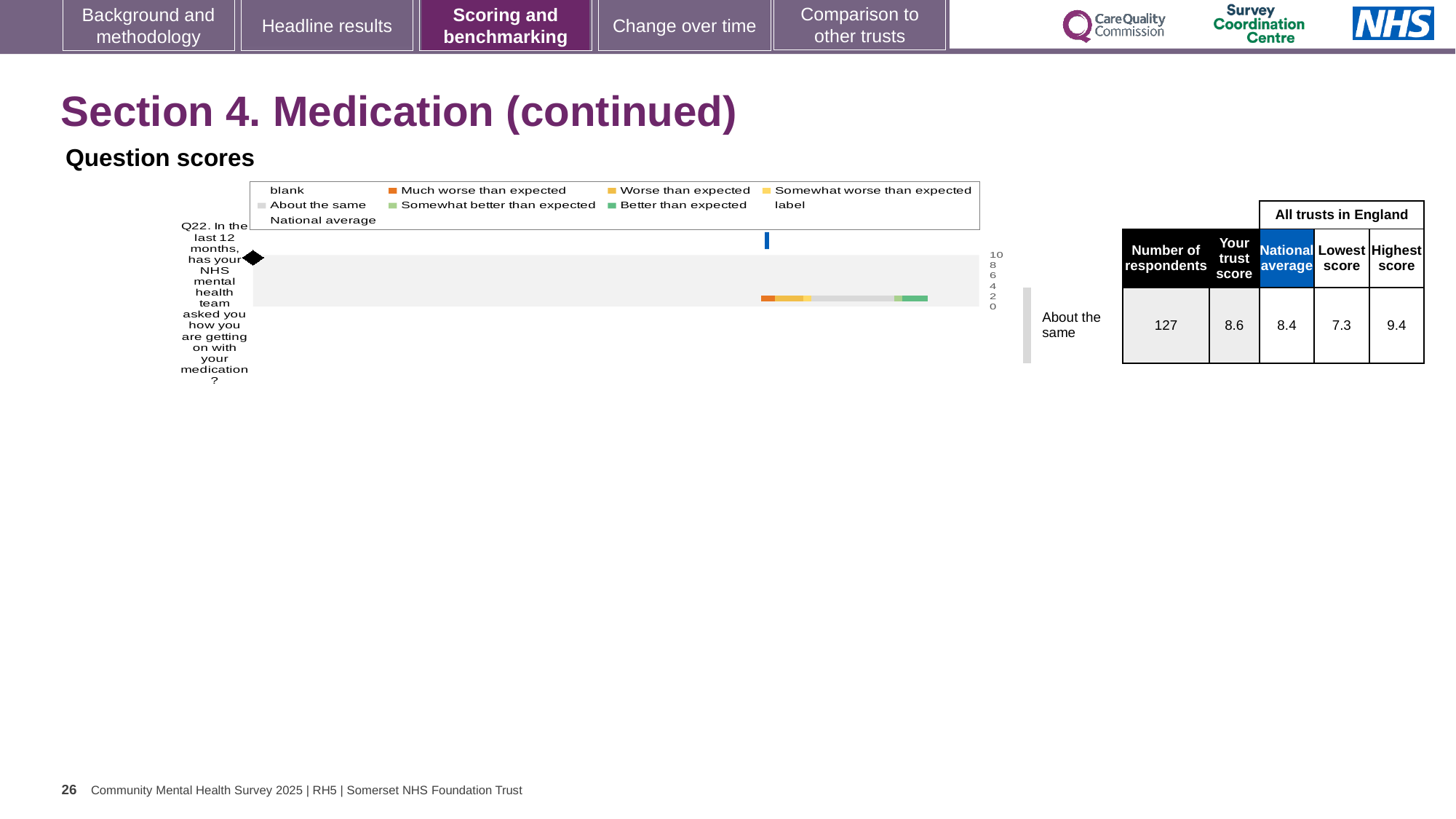
Which question is shown on the Question scores chart? Q22. In the last 12 months, has your NHS mental health team asked you how you are getting on with your medication? What is the national average score for Q22? 8.4 How many respondents answered Q22? 127 What kind of chart is the Question scores chart? bar chart What is the trust score for Q22 on the Question scores chart? 8.6 Is the trust score for Q22 higher or lower than the national average? higher What is the highest score among all trusts in England for Q22? 9.4 What is the difference between the highest and lowest scores among all trusts in England for Q22? 2.1 What benchmarking category is the trust's Q22 score placed in? About the same What is the lowest score among all trusts in England for Q22? 7.3 How many questions are plotted on the Question scores chart? 1 What is the difference between the trust score and the national average for Q22? 0.2